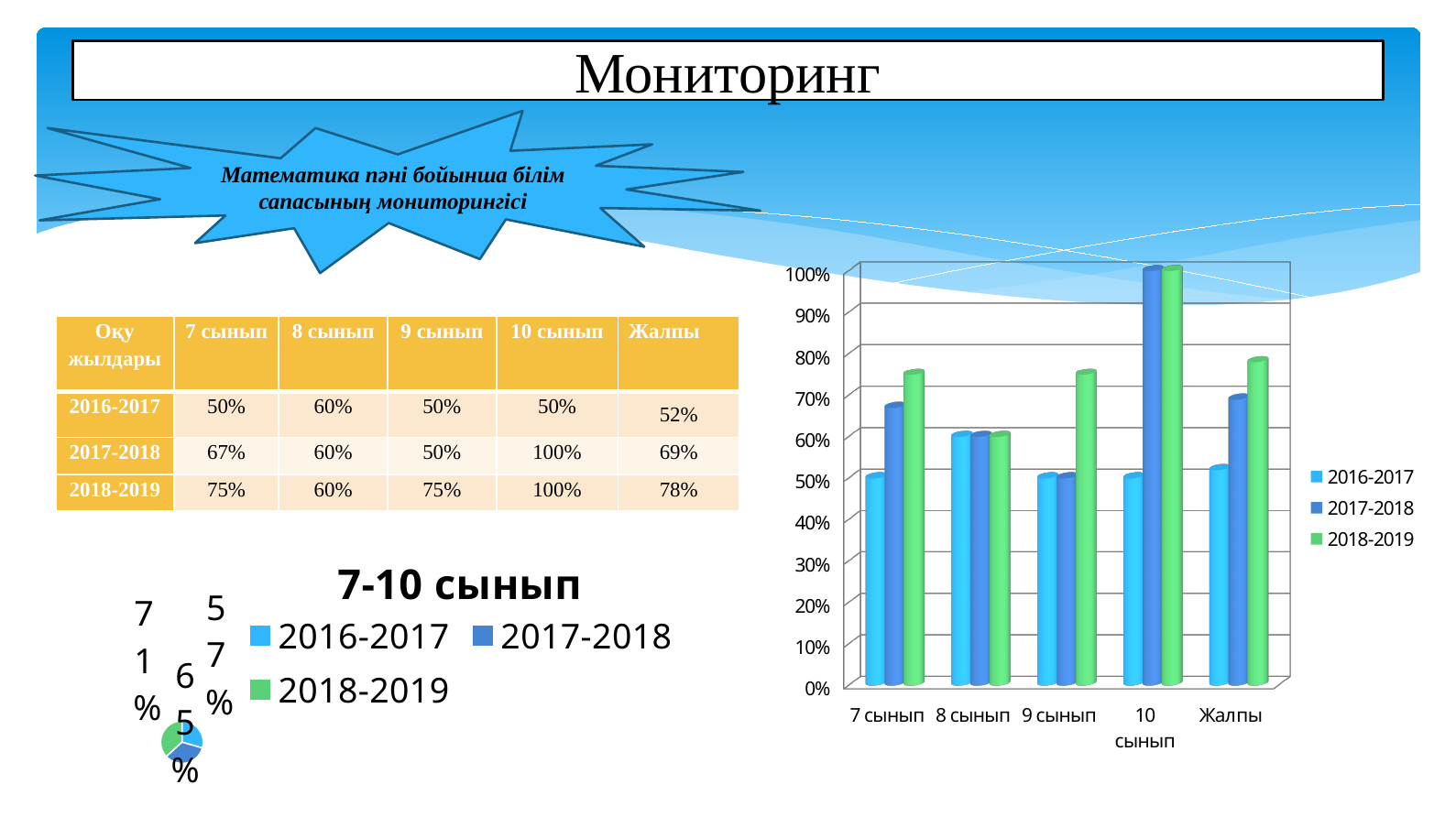
In the bar chart on the right, is the value for 2016-2017 in the Жалпы category greater or less than 60%? less In the bar chart on the right, which series is shown in green in the legend? 2018-2019 In the bar chart on the right, what is the value for 2016-2017 in the 8 сынып category? 60% In the bar chart on the right, is the value for 2018-2019 in the 7 сынып category greater or less than 70%? greater In the bar chart on the right, how many categories are shown on the x axis? 5 In the bar chart on the right, how many series does the legend list? 3 What is the title of the small pie chart at the bottom left of the slide? 7-10 сынып What kind of chart is shown on the right side of the slide? bar chart In the bar chart on the right, what is the value for 2017-2018 in the 10 сынып category? 100% In the bar chart on the right, which category has the highest value for the 2017-2018 series? 10 сынып In the bar chart on the right, which is larger in the 9 сынып category: 2018-2019 or 2017-2018? 2018-2019 In the bar chart on the right, what is the value for 2016-2017 in the 9 сынып category? 50%